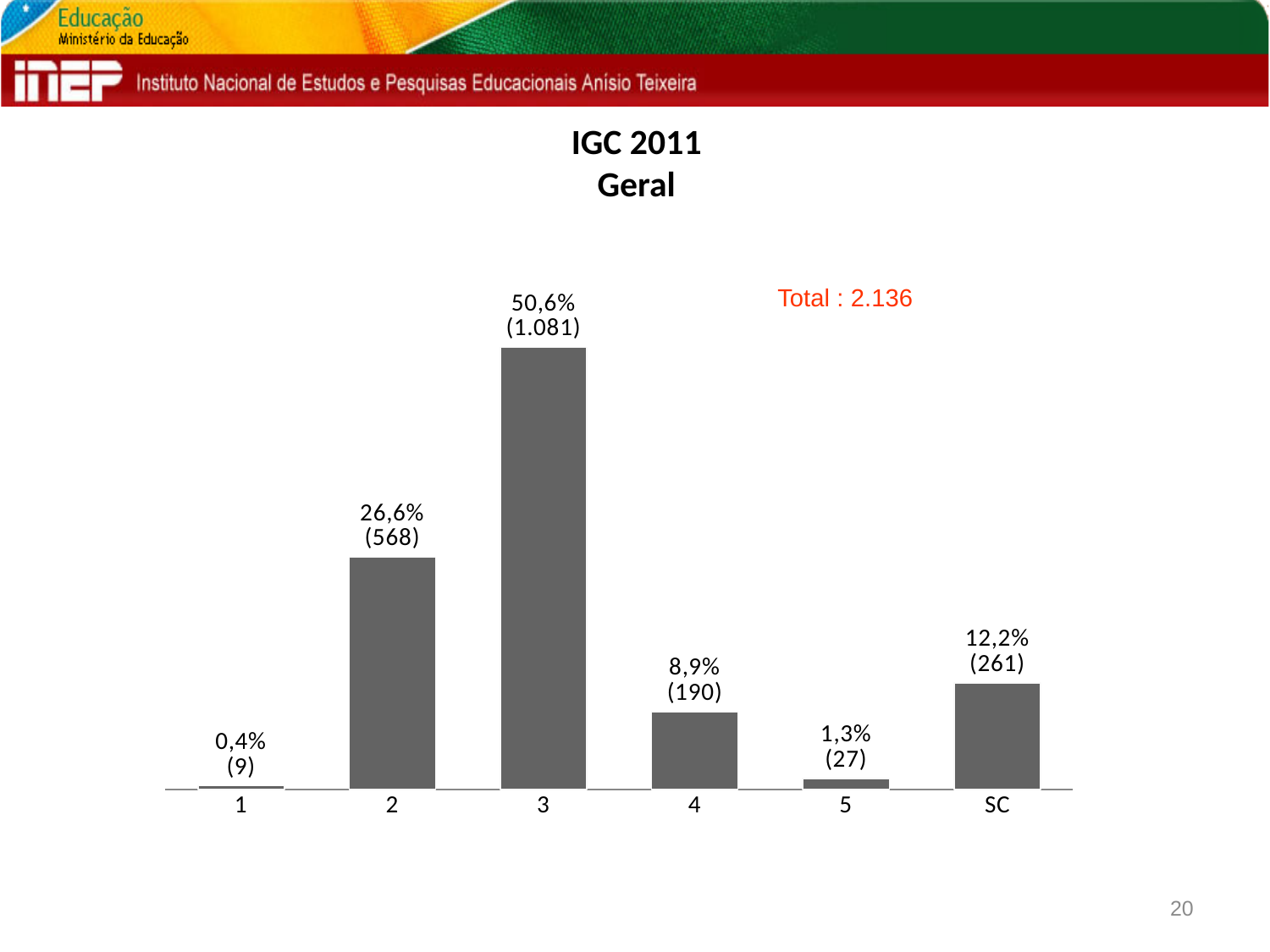
Which category has the lowest value? 1 What is the difference between the counts for category 4 and category 5? 163 Which category has the highest value? 3 What count is shown in parentheses for category 2? 568 Which is larger, the value for category 4 or the value for SC? SC How many categories are shown on the x axis? 6 What total is stated on the slide? 2.136 What is the difference in percentage points between category 3 and category 2? 24 percentage points What percentage is shown for the SC category? 12,2% What percentage is shown for category 3? 50,6% What count is shown in parentheses for category 5? 27 What kind of chart is this? Bar chart